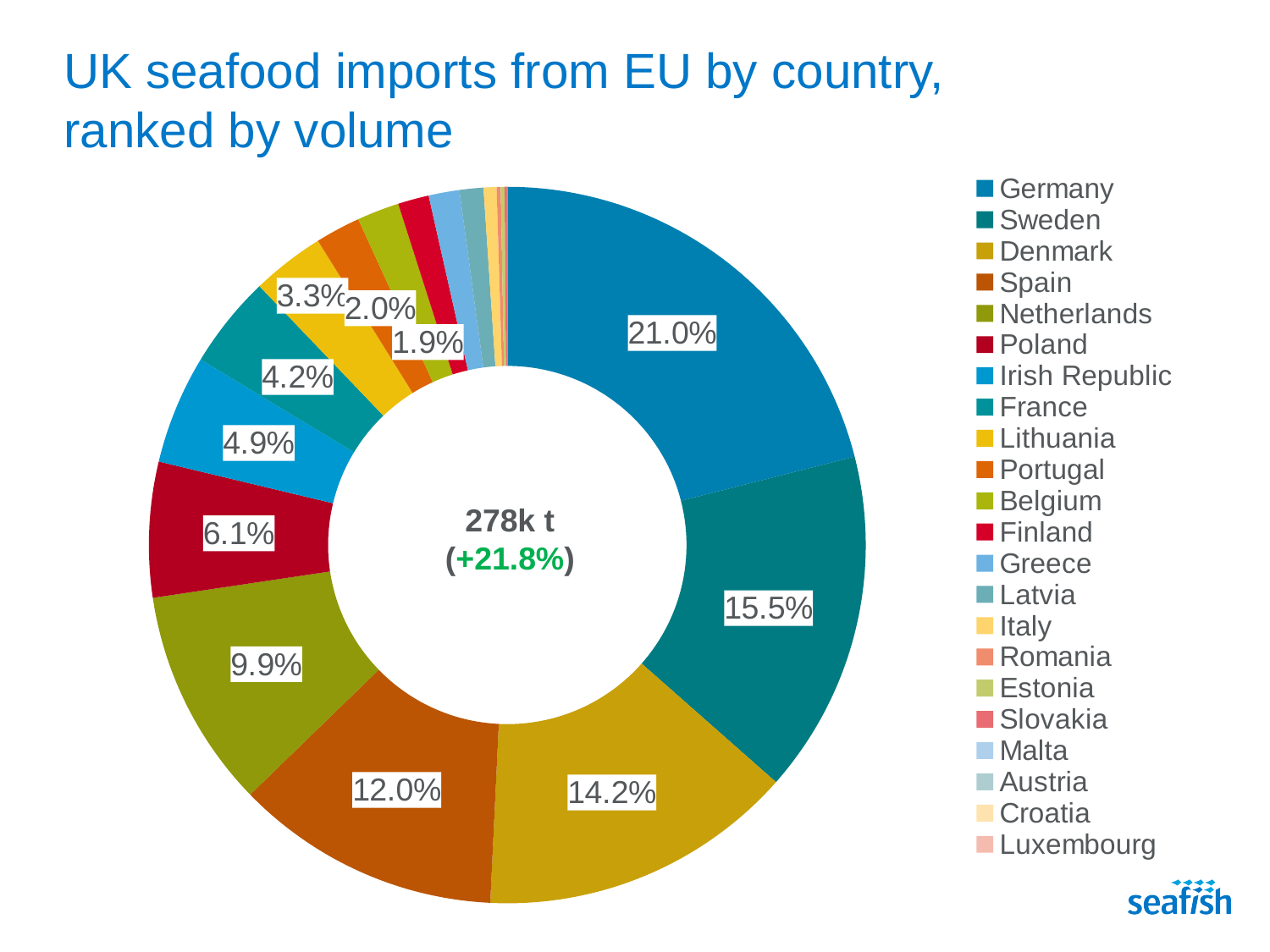
Which country has the largest share of UK seafood imports from the EU? Germany What percentage is shown for Denmark? 14.2% What percentage is shown for the Netherlands? 9.9% What is the difference in percentage points between Spain's share and the Irish Republic's share? 7.1 What percentage change is shown in the centre of the chart? +21.8% What total volume is shown in the centre of the chart? 278k t What type of chart is shown on the slide? Pie chart (donut) Which has the larger share, Spain or Poland? Spain What is the difference in percentage points between Germany's share and Sweden's share? 5.5 What share of the pie does Sweden account for? 15.5% What share of UK seafood imports from the EU comes from Germany? 21.0% How many countries are listed in the legend? 22